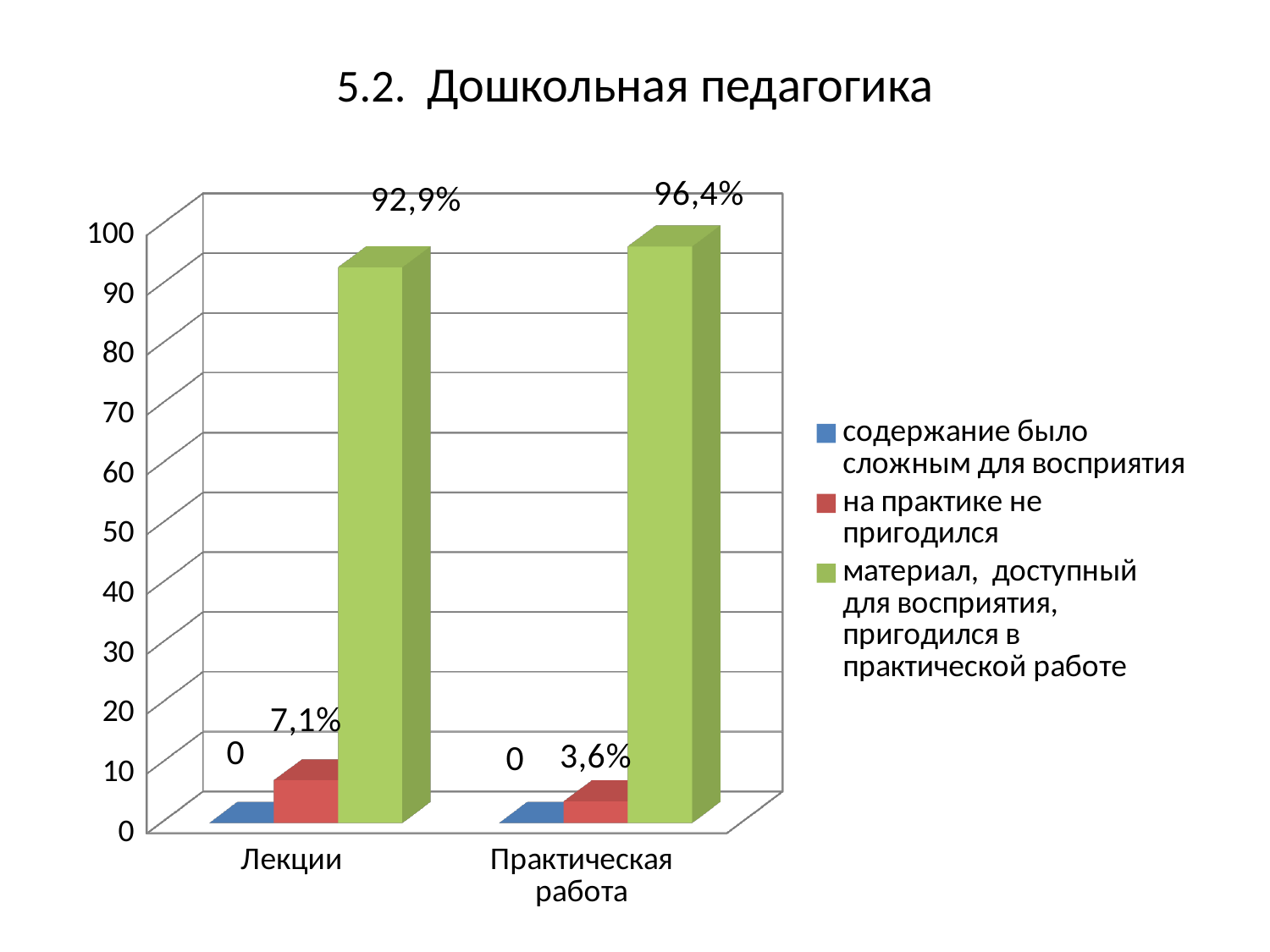
What is the value for "содержание было сложным для восприятия" in the "Лекции" category? 0 How many categories are shown on the x axis? 2 What is the value for "материал, доступный для восприятия, пригодился в практической работе" in the "Лекции" category? 92,9% What is the value for "на практике не пригодился" in the "Практическая работа" category? 3,6% What kind of chart is shown on the slide? bar chart Which category has the lower value for "на практике не пригодился"? Практическая работа Which category has the higher value for "материал, доступный для восприятия, пригодился в практической работе"? Практическая работа What is the value for "на практике не пригодился" in the "Лекции" category? 7,1% How many series does the legend list? 3 What is the difference between the "на практике не пригодился" values for "Лекции" and "Практическая работа"? 3,5% What is the value for "материал, доступный для восприятия, пригодился в практической работе" in the "Практическая работа" category? 96,4% Is the value for "материал, доступный для восприятия, пригодился в практической работе" in "Лекции" greater or less than 90? greater